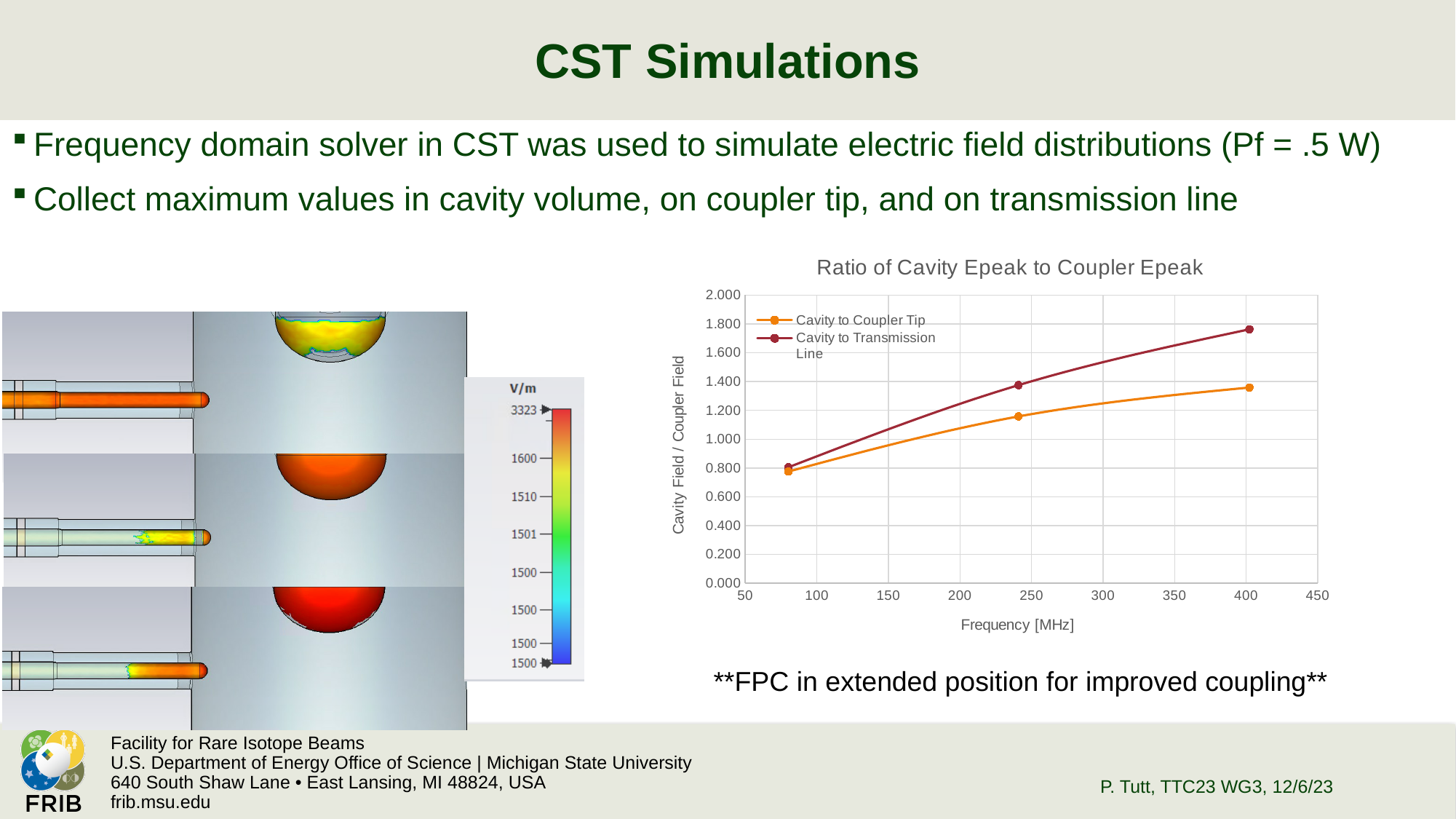
At the lowest plotted frequency (around 80 MHz), is the value for "Cavity to Coupler Tip" greater or less than 1.000? less At the highest plotted frequency (around 400 MHz), which series has the larger value: "Cavity to Coupler Tip" or "Cavity to Transmission Line"? Cavity to Transmission Line How many data points are plotted for the "Cavity to Coupler Tip" series? 3 Do the values of the "Cavity to Transmission Line" series rise or fall as frequency increases? rise What kind of chart is shown under the title "Ratio of Cavity Epeak to Coupler Epeak"? line chart Do the values of the "Cavity to Coupler Tip" series rise or fall as frequency increases? rise At the highest plotted frequency (around 400 MHz), is the value for "Cavity to Coupler Tip" greater or less than 1.200? greater At the middle plotted frequency (around 240 MHz), is the value for "Cavity to Transmission Line" greater or less than 1.200? greater What colour is the line for the "Cavity to Coupler Tip" series? orange What is the label of the x axis of the "Ratio of Cavity Epeak to Coupler Epeak" chart? Frequency [MHz] How many series does the legend of the "Ratio of Cavity Epeak to Coupler Epeak" chart list? 2